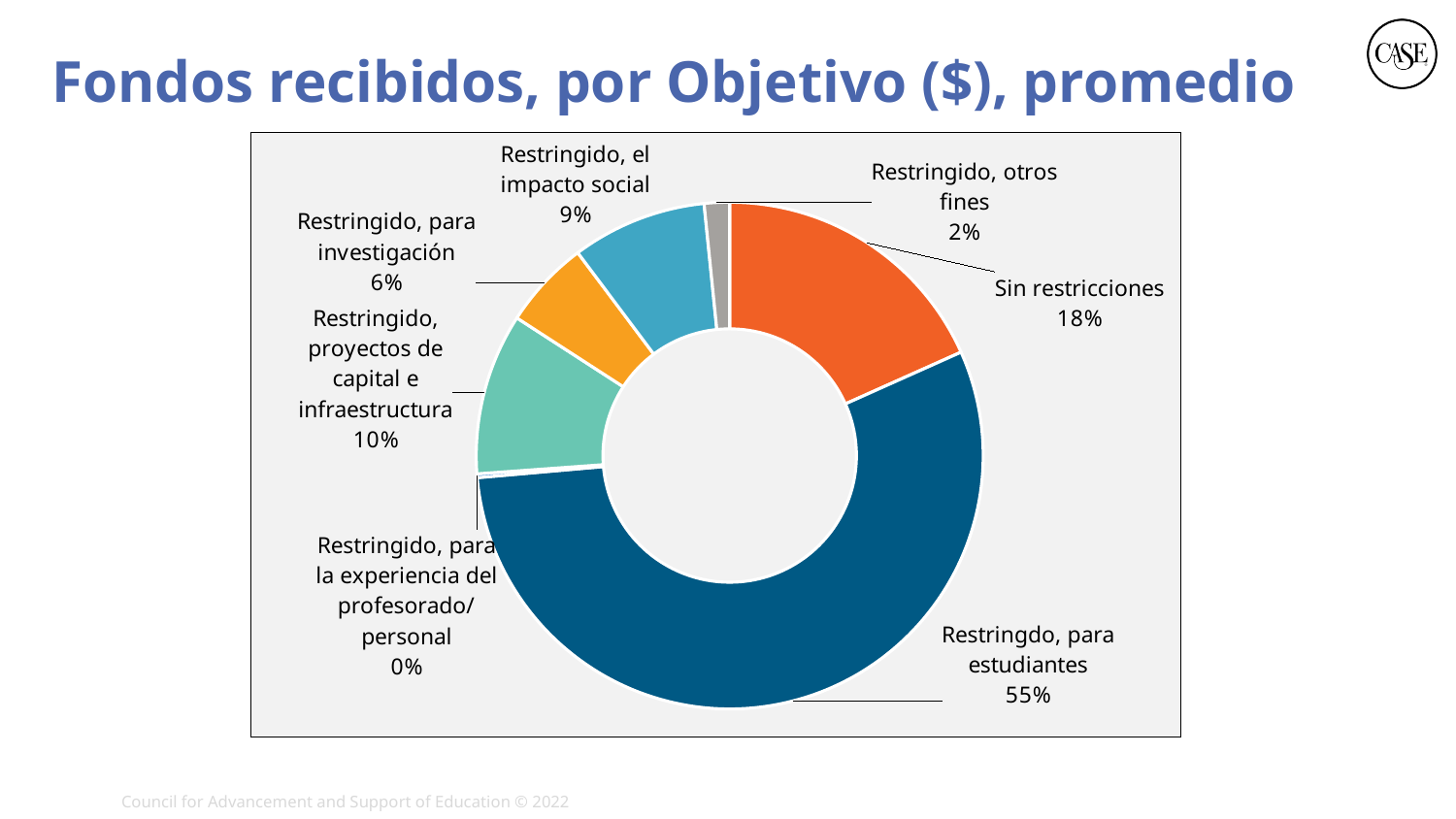
What kind of chart is shown on the slide? Pie chart (donut) Which category has the smallest share of the chart? Restringido, para la experiencia del profesorado/personal What percentage is shown for "Restringido, el impacto social"? 9% Which category has the largest share of the chart? Restringdo, para estudiantes What is the difference in percentage points between "Restringdo, para estudiantes" and "Sin restricciones"? 37 What percentage is shown for "Sin restricciones"? 18% What percentage is shown for "Restringido, para investigación"? 6% What percentage is shown for "Restringido, otros fines"? 2% What share of funds received goes to "Restringdo, para estudiantes"? 55% What percentage is shown for "Restringido, proyectos de capital e infraestructura"? 10% How many categories are shown in the chart? 7 Which is larger: the share for "Restringido, proyectos de capital e infraestructura" or the share for "Restringido, para investigación"? Restringido, proyectos de capital e infraestructura